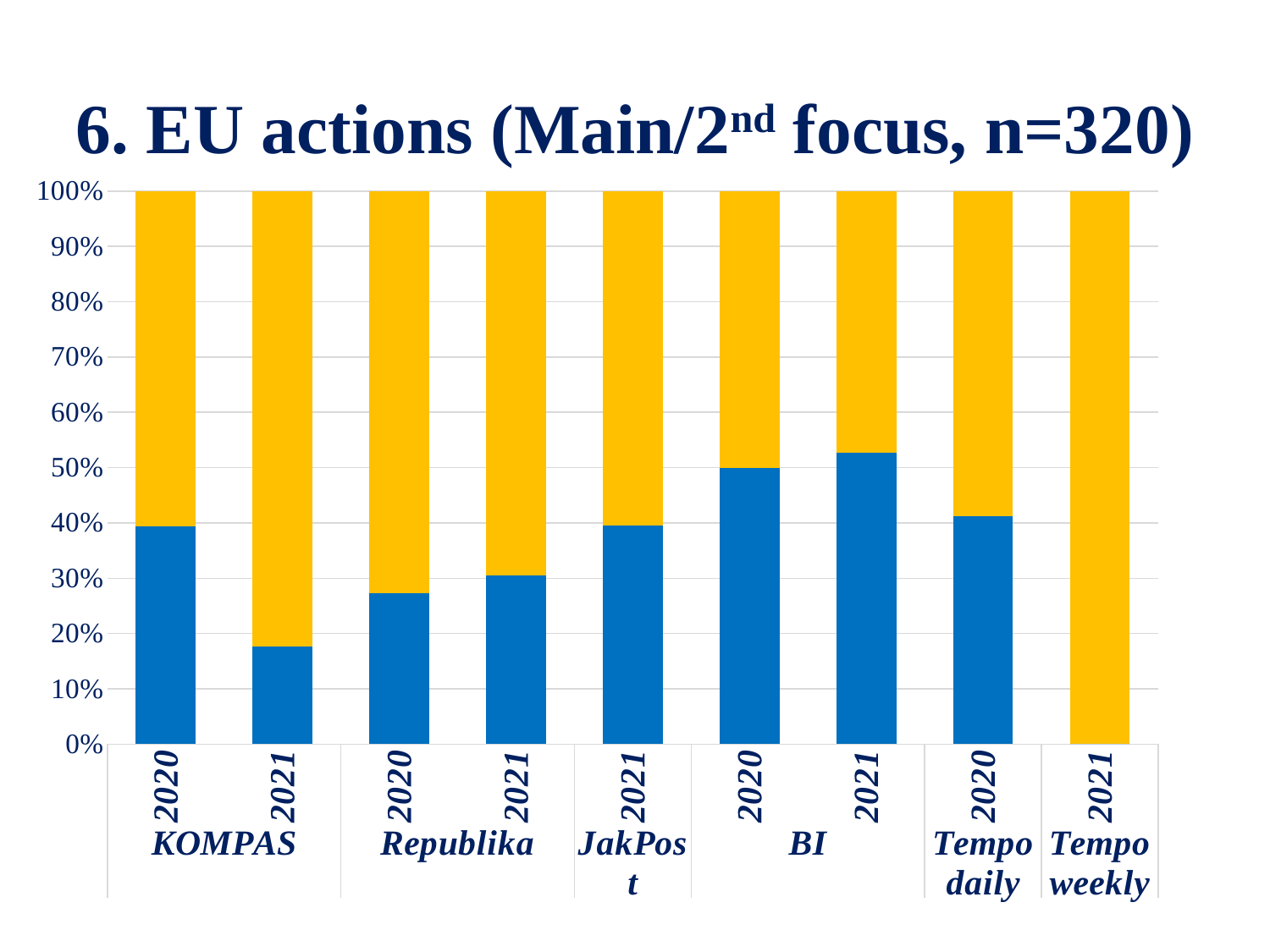
Is the blue segment for BI 2021 greater or less than 50%? greater How many media outlets are labelled along the x axis? 6 What is the highest value shown on the y axis? 100% For KOMPAS, which year has the larger blue segment, 2020 or 2021? 2020 Is the blue segment for Republika 2020 greater or less than 30%? less Which bar has no blue segment at all? Tempo weekly 2021 For Republika, which year has the larger blue segment, 2020 or 2021? 2021 Is the blue segment for Tempo daily 2020 greater or less than 40%? greater What kind of chart is shown on the slide? Stacked bar chart How many bars are plotted in the chart? 9 What is the title of the slide? 6. EU actions (Main/2nd focus, n=320)